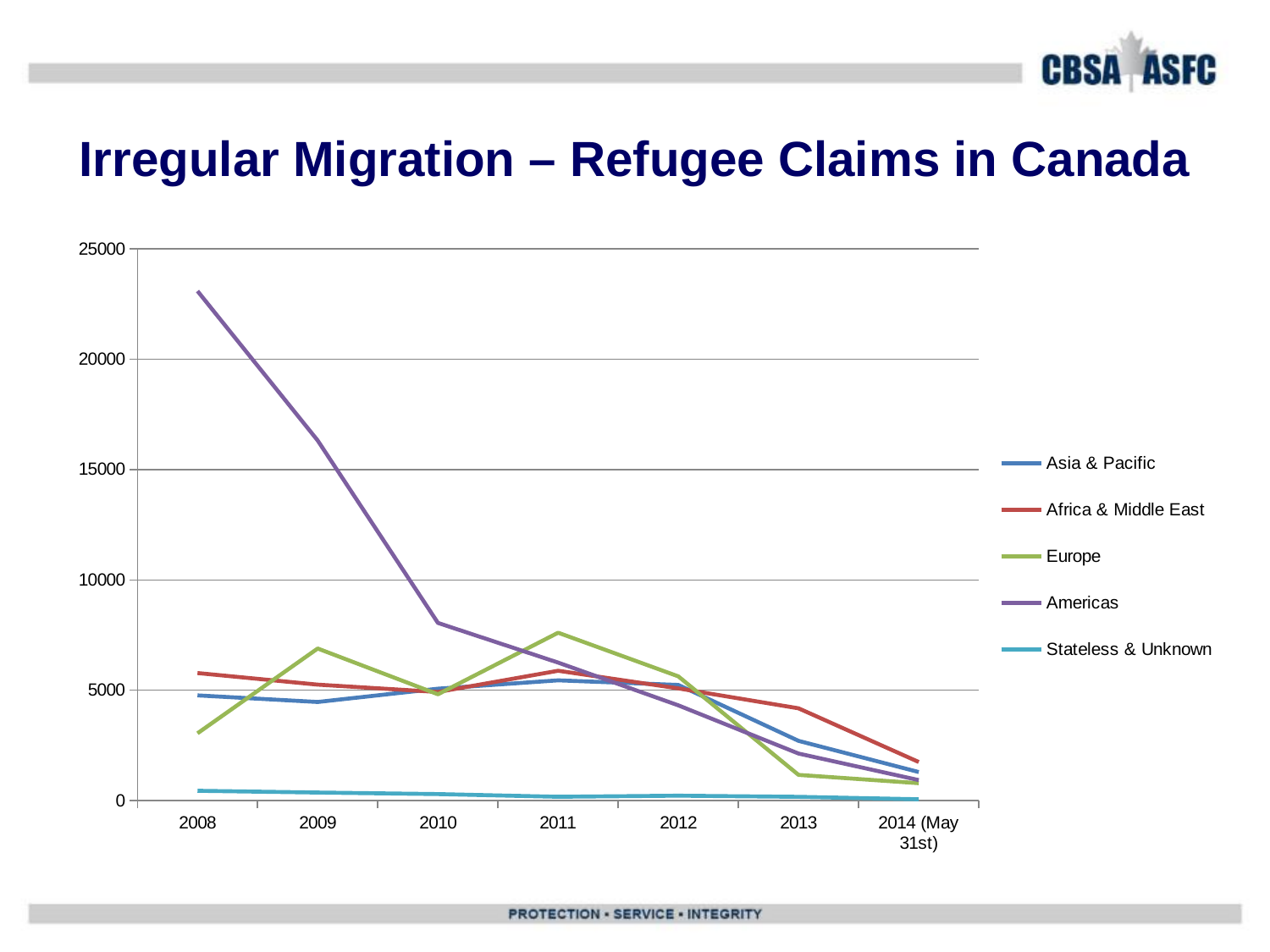
Is the value for Europe in 2013 greater or less than 5000? less What is the title of the slide containing the chart? Irregular Migration – Refugee Claims in Canada How many years (points) are shown along the x axis? 7 Is the value for Europe in 2009 greater or less than 5000? greater Is the value for Americas in 2010 greater or less than 10000? less Does the Americas series rise or fall from 2008 to 2014 (May 31st)? Fall In 2008, which is larger: Asia & Pacific or Europe? Asia & Pacific What kind of chart is shown on the slide? Line chart Which series has the highest value in 2008? Americas Which series has the lowest value in 2008? Stateless & Unknown How many series does the legend list? 5